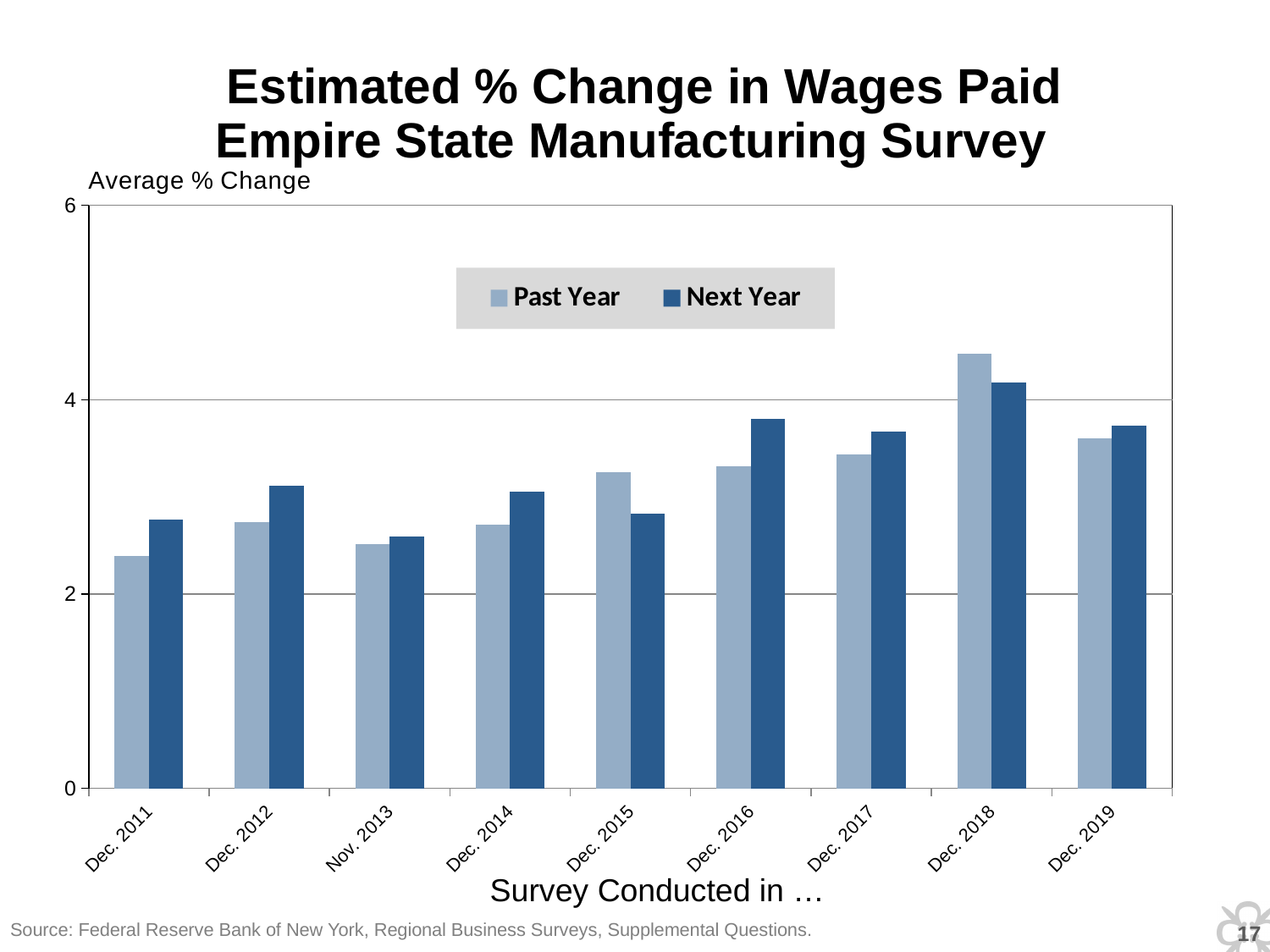
Which survey date has the highest Next Year value? Dec. 2018 How many survey dates are shown along the x axis? 9 What are the two entries in the legend? Past Year and Next Year Which survey date has the highest Past Year value? Dec. 2018 Is the Past Year value for Dec. 2011 greater or less than 2? greater Is the Next Year value for Dec. 2016 greater or less than 4? less For Dec. 2015, which is larger, the Past Year value or the Next Year value? Past Year How many series does the legend list? 2 Which survey date has the lowest Past Year value? Dec. 2011 Is the Past Year value for Dec. 2018 greater or less than 4? greater For Dec. 2016, which is larger, the Past Year value or the Next Year value? Next Year What kind of chart is shown on the slide? Bar chart